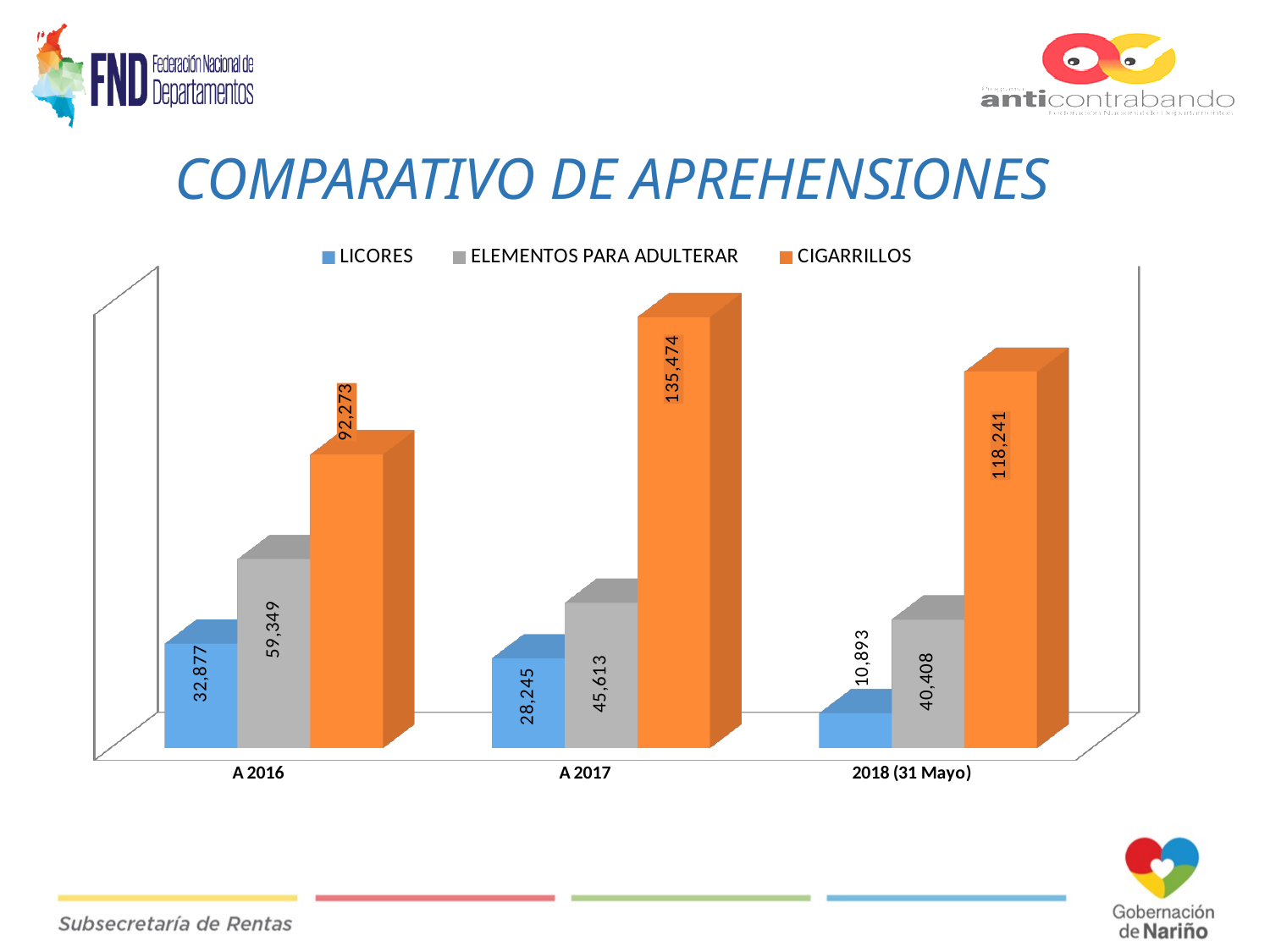
How many year categories are shown on the x axis? 3 What is the value for CIGARRILLOS in A 2017? 135,474 In which year is the LICORES value lowest? 2018 (31 Mayo) Which is larger: ELEMENTOS PARA ADULTERAR in A 2017 or in 2018 (31 Mayo)? A 2017 In which year does CIGARRILLOS reach its highest value? A 2017 Do the LICORES values rise or fall from A 2016 to 2018 (31 Mayo)? Fall How many series does the legend list? 3 What is the title of the chart? COMPARATIVO DE APREHENSIONES What kind of chart is shown on the slide? Bar chart What is the difference between the CIGARRILLOS values for A 2017 and A 2016? 43,201 What is the value for ELEMENTOS PARA ADULTERAR in A 2016? 59,349 What is the value for LICORES in 2018 (31 Mayo)? 10,893